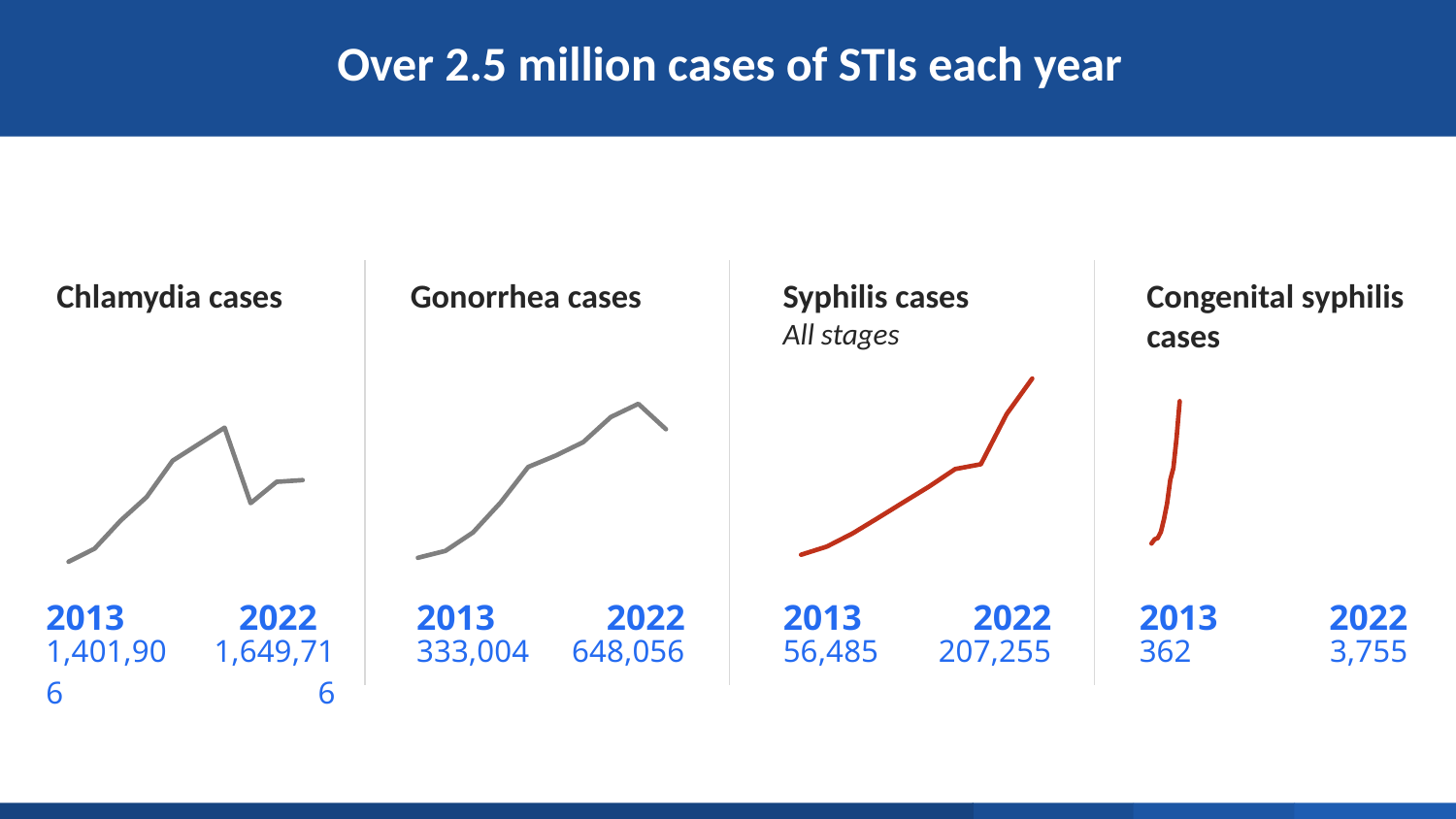
In the Syphilis cases chart, what is the value for 2013? 56,485 In the Syphilis cases chart, do the values rise or fall from 2013 to 2022? Rise In the Congenital syphilis cases chart, what is the difference between the 2022 and 2013 values? 3,393 In the Gonorrhea cases chart, what is the difference between the 2022 and 2013 values? 315,052 In the Chlamydia cases chart, what is the value for 2022? 1,649,716 In the Congenital syphilis cases chart, what is the value for 2022? 3,755 What kind of chart is used for the Syphilis cases panel? Line chart In the Congenital syphilis cases chart, which year has the larger value, 2013 or 2022? 2022 In the Chlamydia cases chart, what is the value for 2013? 1,401,906 In the Gonorrhea cases chart, what is the value for 2022? 648,056 In the Syphilis cases chart, what is the difference between the 2022 and 2013 values? 150,770 How many charts are shown on the slide? 4